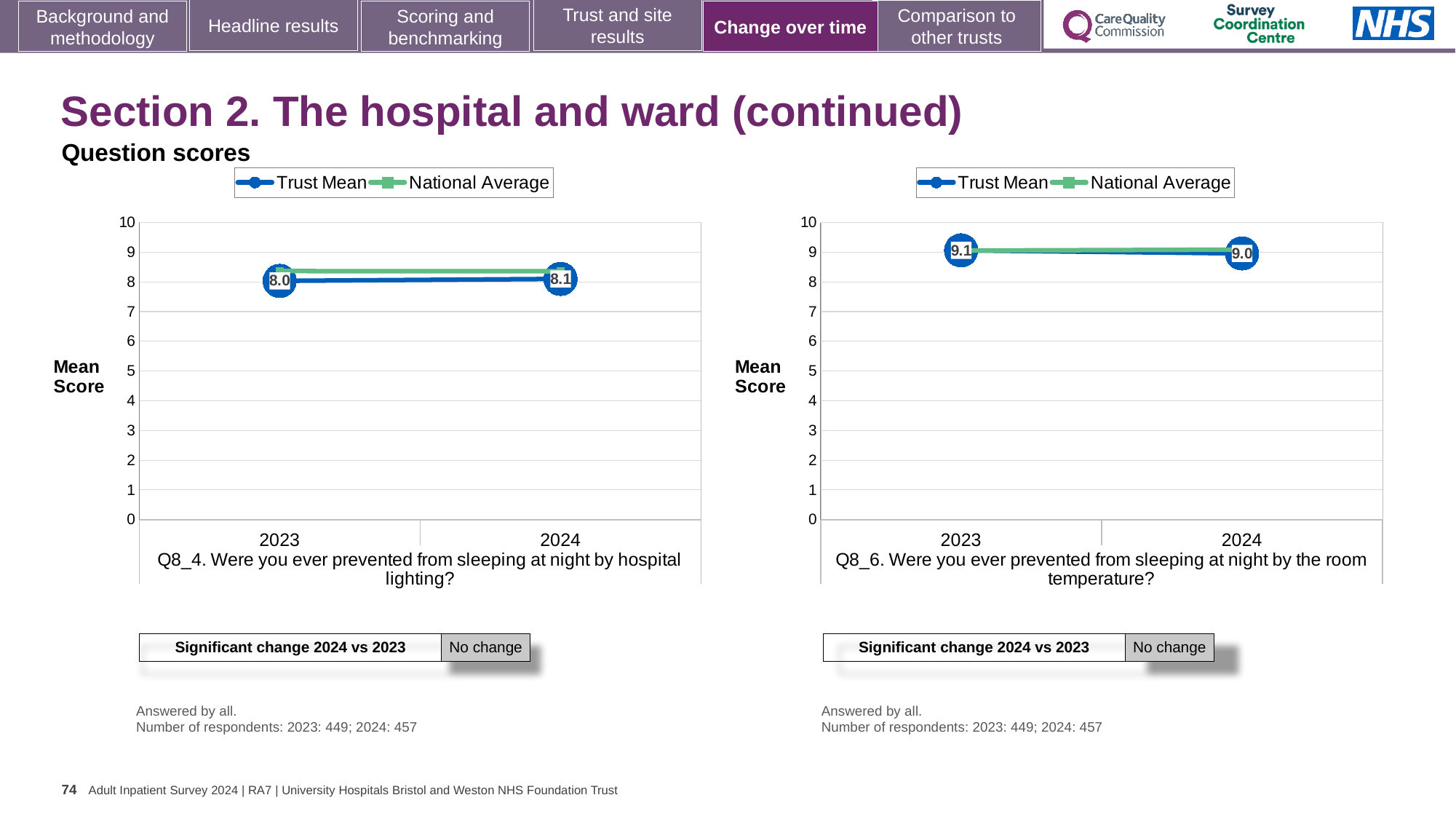
In the Q8_4 chart (left), what is the Trust Mean score for 2024? 8.1 What kind of chart is the Q8_6 chart (right)? Line chart In the Q8_4 chart (left), what is the Trust Mean score for 2023? 8.0 How many years are shown on the x axis of the Q8_6 chart (right)? 2 In the Q8_4 chart (left), by how much did the Trust Mean change from 2023 to 2024? 0.1 How many series does the legend of the Q8_4 chart (left) list? 2 What does the 'Significant change 2024 vs 2023' box below the Q8_6 chart (right) say? No change In the Q8_6 chart (right), which year has the higher Trust Mean, 2023 or 2024? 2023 In the Q8_6 chart (right), what is the Trust Mean score for 2023? 9.1 In the Q8_4 chart (left), is the National Average value for 2023 greater or less than 8? greater In the Q8_6 chart (right), what is the Trust Mean score for 2024? 9.0 In the Q8_4 chart (left), does the Trust Mean rise or fall from 2023 to 2024? Rise